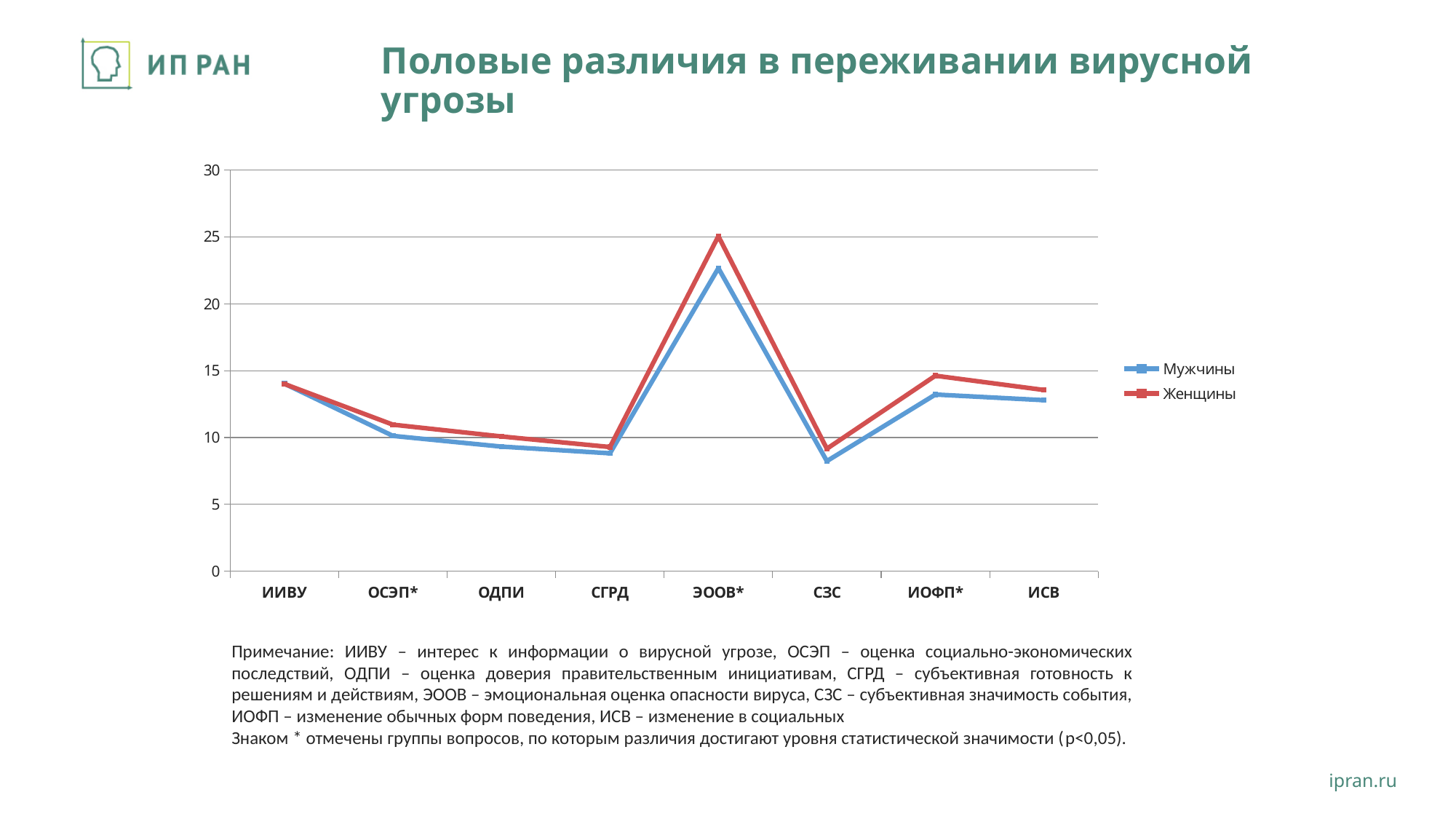
What kind of chart is shown on the slide? line chart Do the values for Женщины rise or fall from ЭООВ* to СЗС? fall How many categories are shown on the x axis? 8 Which colour is used for the Мужчины series? blue Is the value for Женщины at ЭООВ* greater or less than 20? greater For which category is the value for Женщины highest? ЭООВ* For which category is the value for Мужчины highest? ЭООВ* How many series does the legend list? 2 For which category is the value for Мужчины lowest? СЗС Is the value for Мужчины at ИИВУ greater or less than 15? less Is the value for Мужчины at СЗС greater or less than 10? less At ЭООВ*, which series has the larger value, Мужчины or Женщины? Женщины